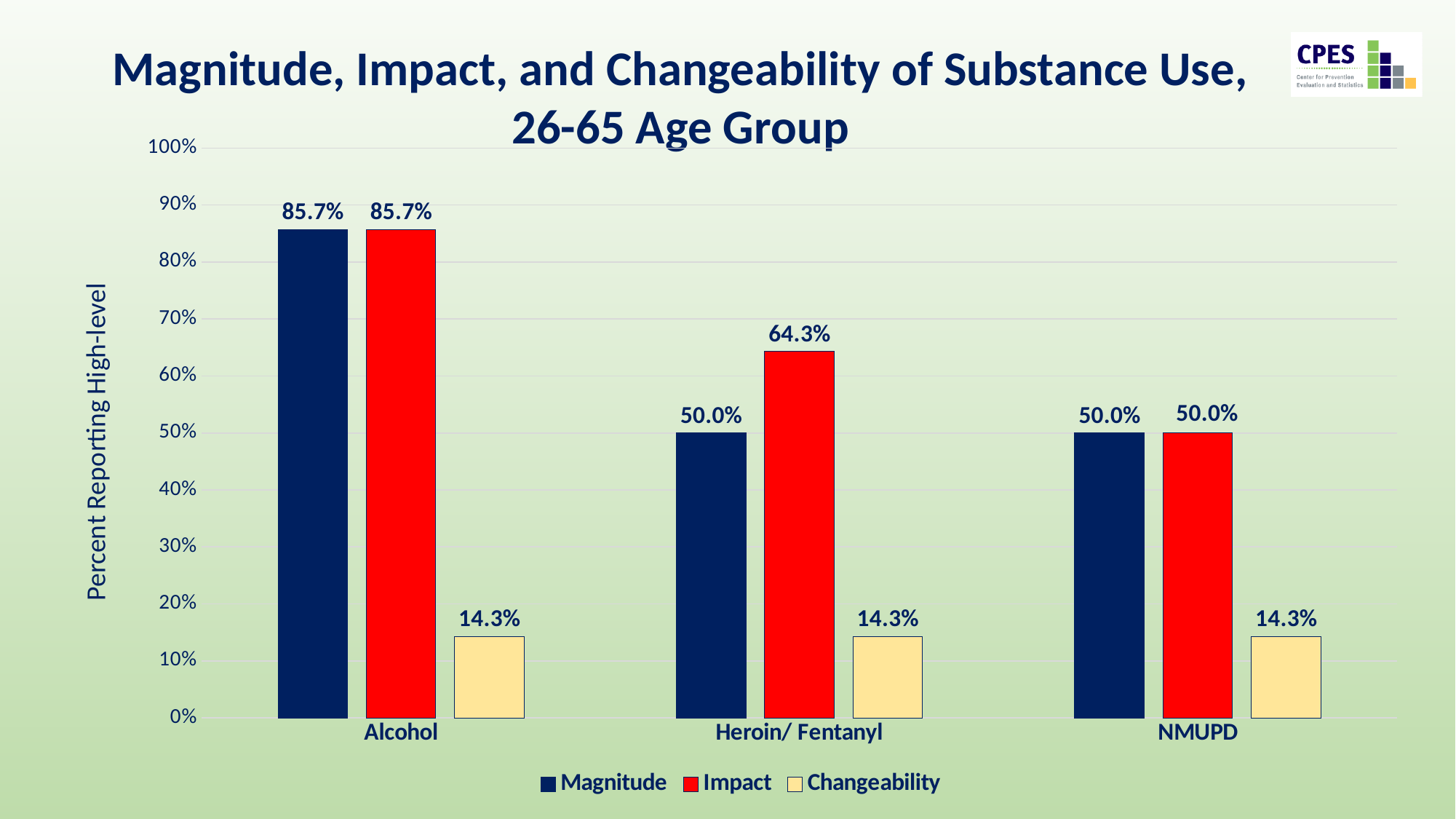
Which is larger, the Impact value for Heroin/ Fentanyl or the Impact value for NMUPD? Heroin/ Fentanyl What is the Impact value for Heroin/ Fentanyl? 64.3% Which category has the highest Impact value? Alcohol What is the difference between the Magnitude and Changeability values for NMUPD? 35.7% What is the label of the y axis? Percent Reporting High-level How many series does the legend list? 3 What is the Changeability value for NMUPD? 14.3% What is the difference between the Impact value for Alcohol and the Impact value for Heroin/ Fentanyl? 21.4% How many categories are shown on the x axis? 3 Which series has the lowest value for Heroin/ Fentanyl? Changeability What is the Magnitude value for Alcohol? 85.7% What kind of chart is shown on the slide? Bar chart